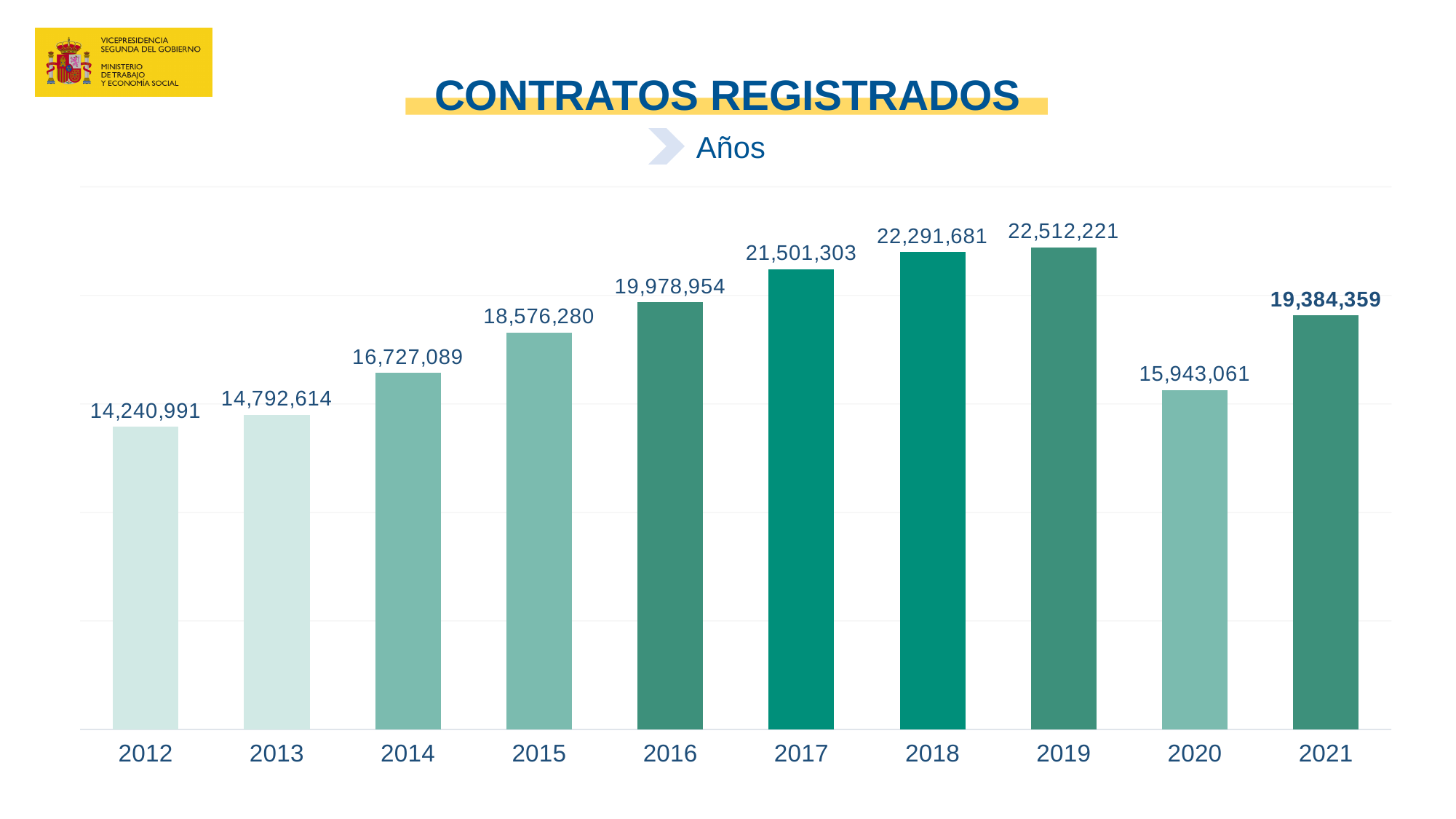
What is the difference between the values for 2021 and 2020? 3,441,298 Do the values rise or fall from 2012 to 2019? rise What is the difference between the values for 2019 and 2012? 8,271,230 What is the title of the chart? CONTRATOS REGISTRADOS How many years are shown on the chart? 10 What kind of chart is shown? bar chart What is the value for 2021? 19,384,359 Which year has the highest value? 2019 Which year has the lowest value? 2012 What is the value for 2016? 19,978,954 Which is larger, the value for 2017 or the value for 2021? 2017 What is the value for 2012? 14,240,991